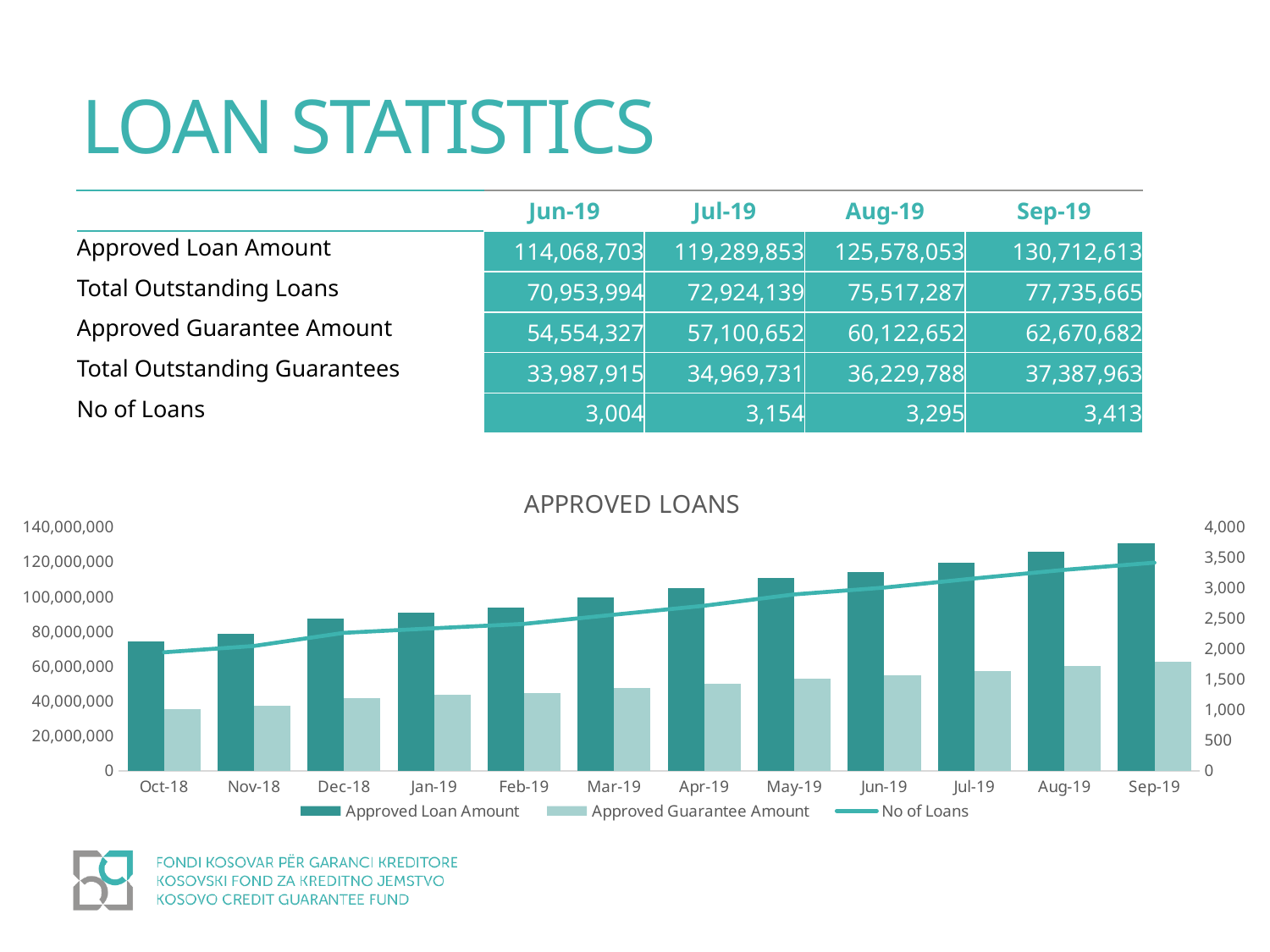
In the APPROVED LOANS chart, does the Approved Loan Amount rise or fall from Oct-18 to Sep-19? Rise In the APPROVED LOANS chart, is the Approved Guarantee Amount for Oct-18 greater or less than 40,000,000? less How many months are shown on the x axis of the APPROVED LOANS chart? 12 What is the Approved Loan Amount for Sep-19 shown on the slide? 130,712,613 In the APPROVED LOANS chart, which month has the highest Approved Loan Amount? Sep-19 In the APPROVED LOANS chart, which month has the lowest Approved Guarantee Amount? Oct-18 How many series does the legend of the APPROVED LOANS chart list? 3 What kind of chart is shown under the title APPROVED LOANS? A bar chart with a line series By how much does the No of Loans in Sep-19 exceed the No of Loans in Jun-19, according to the slide? 409 In the APPROVED LOANS chart, is the Approved Loan Amount for Apr-19 greater or less than 100,000,000? greater In the APPROVED LOANS chart, which is larger in Jul-19: the Approved Loan Amount or the Approved Guarantee Amount? Approved Loan Amount In the APPROVED LOANS chart, is the Approved Loan Amount for Oct-18 greater or less than 80,000,000? less